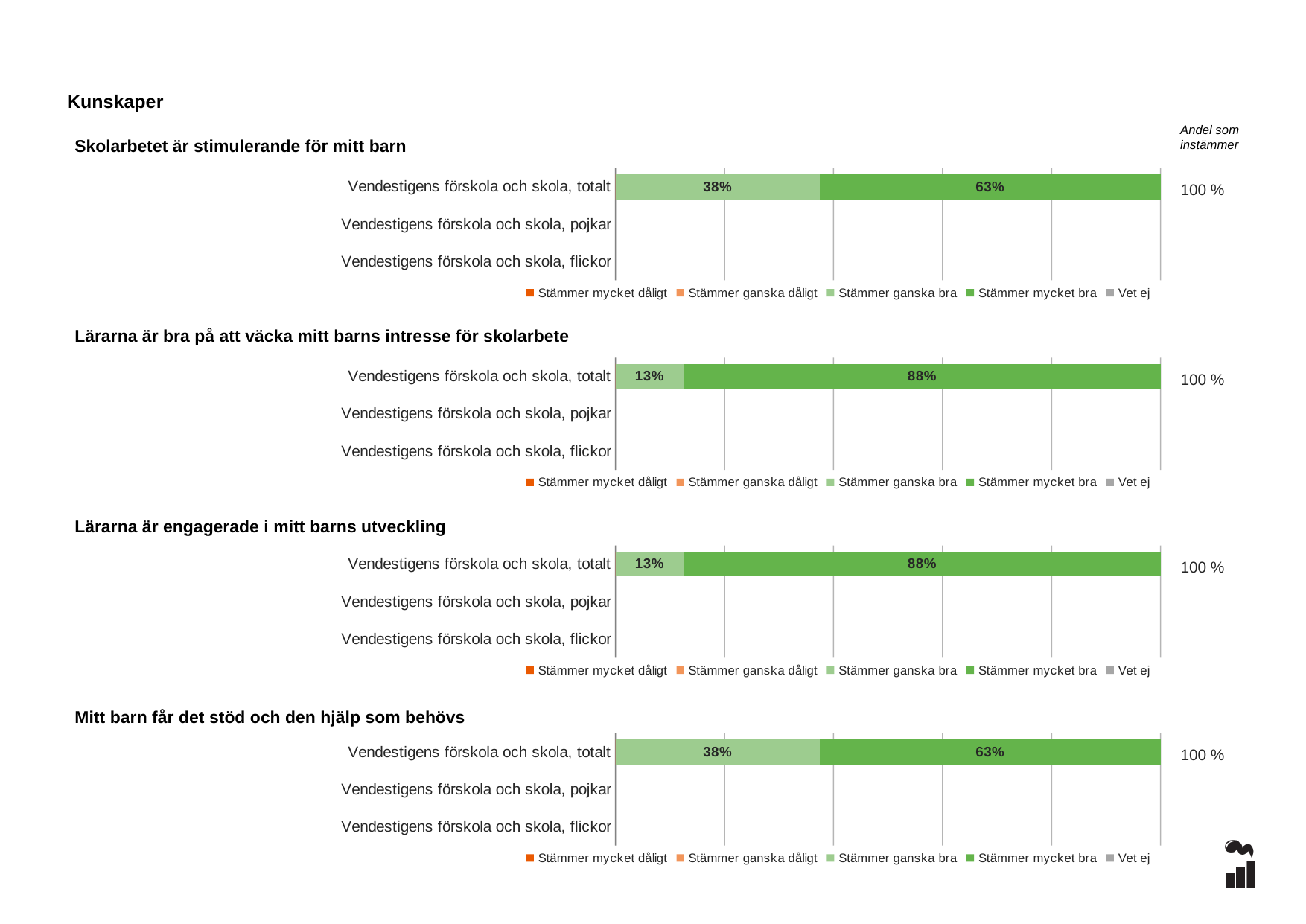
In the chart 'Mitt barn får det stöd och den hjälp som behövs', what is the value for 'Stämmer mycket bra' for Vendestigens förskola och skola, totalt? 63% In the chart 'Skolarbetet är stimulerande för mitt barn', what is the difference between the 'Stämmer mycket bra' and 'Stämmer ganska bra' values for Vendestigens förskola och skola, totalt? 25% In the chart 'Lärarna är bra på att väcka mitt barns intresse för skolarbete', what is the difference between the 'Stämmer mycket bra' and 'Stämmer ganska bra' values for Vendestigens förskola och skola, totalt? 75% In the chart 'Mitt barn får det stöd och den hjälp som behövs', which is larger for Vendestigens förskola och skola, totalt: 'Stämmer ganska bra' or 'Stämmer mycket bra'? Stämmer mycket bra What is the 'Andel som instämmer' shown for Vendestigens förskola och skola, totalt in the chart 'Lärarna är engagerade i mitt barns utveckling'? 100 % How many series does the legend list in the chart 'Lärarna är engagerade i mitt barns utveckling'? 5 In the chart 'Skolarbetet är stimulerande för mitt barn', what is the value for 'Stämmer ganska bra' for Vendestigens förskola och skola, totalt? 38% What kind of chart is 'Lärarna är bra på att väcka mitt barns intresse för skolarbete'? Stacked bar chart In the chart 'Lärarna är bra på att väcka mitt barns intresse för skolarbete', what is the value for 'Stämmer mycket bra' for Vendestigens förskola och skola, totalt? 88% In the chart 'Lärarna är engagerade i mitt barns utveckling', what is the value for 'Stämmer ganska bra' for Vendestigens förskola och skola, totalt? 13% In the chart 'Skolarbetet är stimulerande för mitt barn', what is the value for 'Stämmer mycket bra' for Vendestigens förskola och skola, totalt? 63% How many categories are listed on the y axis of the chart 'Skolarbetet är stimulerande för mitt barn'? 3